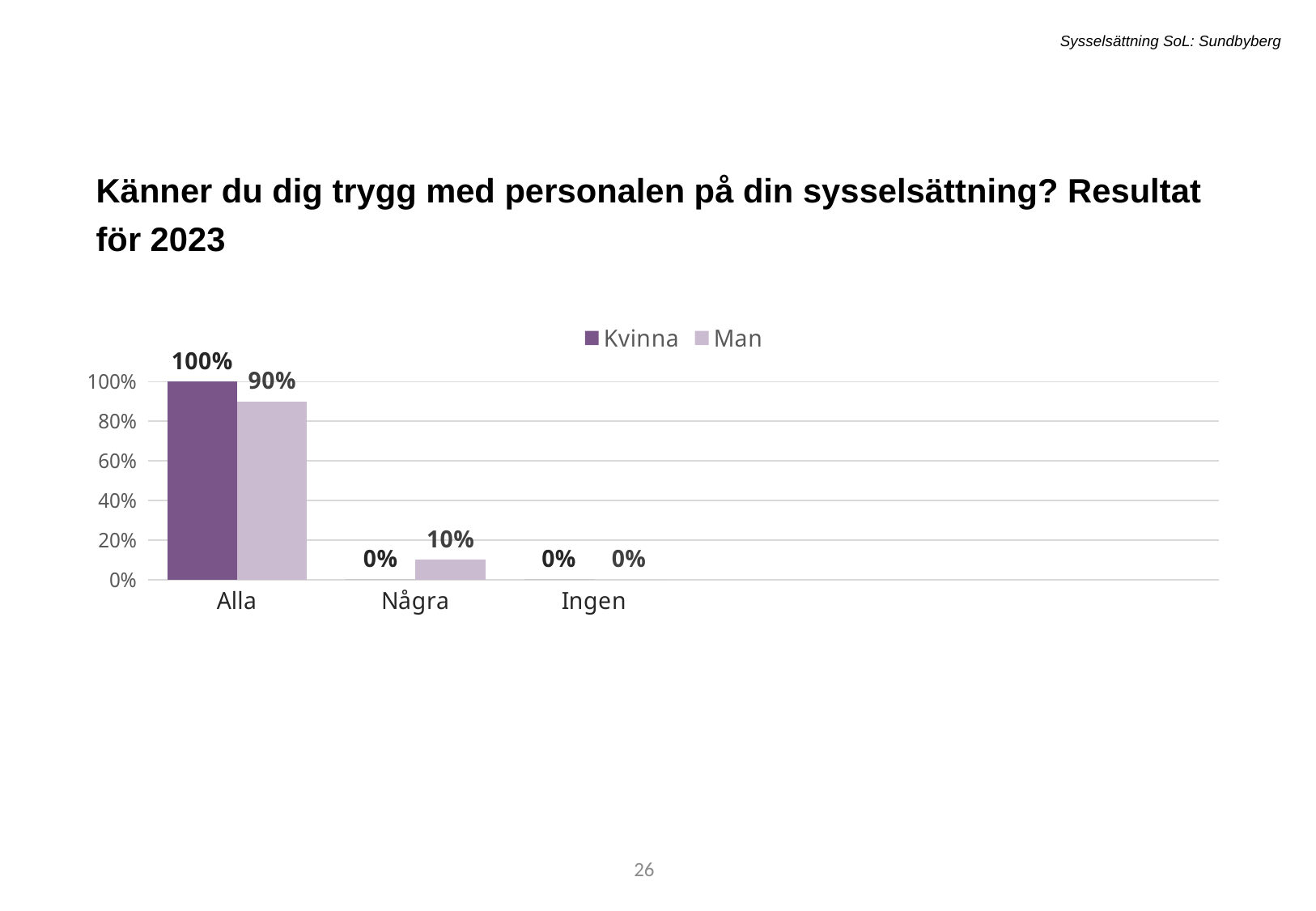
Which is larger in the Alla category, the Kvinna value or the Man value? Kvinna What is the value for Man in the Alla category? 90% What is the difference between the Kvinna and Man values in the Alla category? 10% Which category has the highest value for the Man series? Alla What kind of chart is shown on the slide? Bar chart What is the value for Kvinna in the Några category? 0% What is the value for Man in the Ingen category? 0% How many categories are shown on the x axis? 3 How many series does the legend list? 2 What is the value for Kvinna in the Alla category? 100% What is the value for Man in the Några category? 10% What are the two series named in the legend? Kvinna and Man